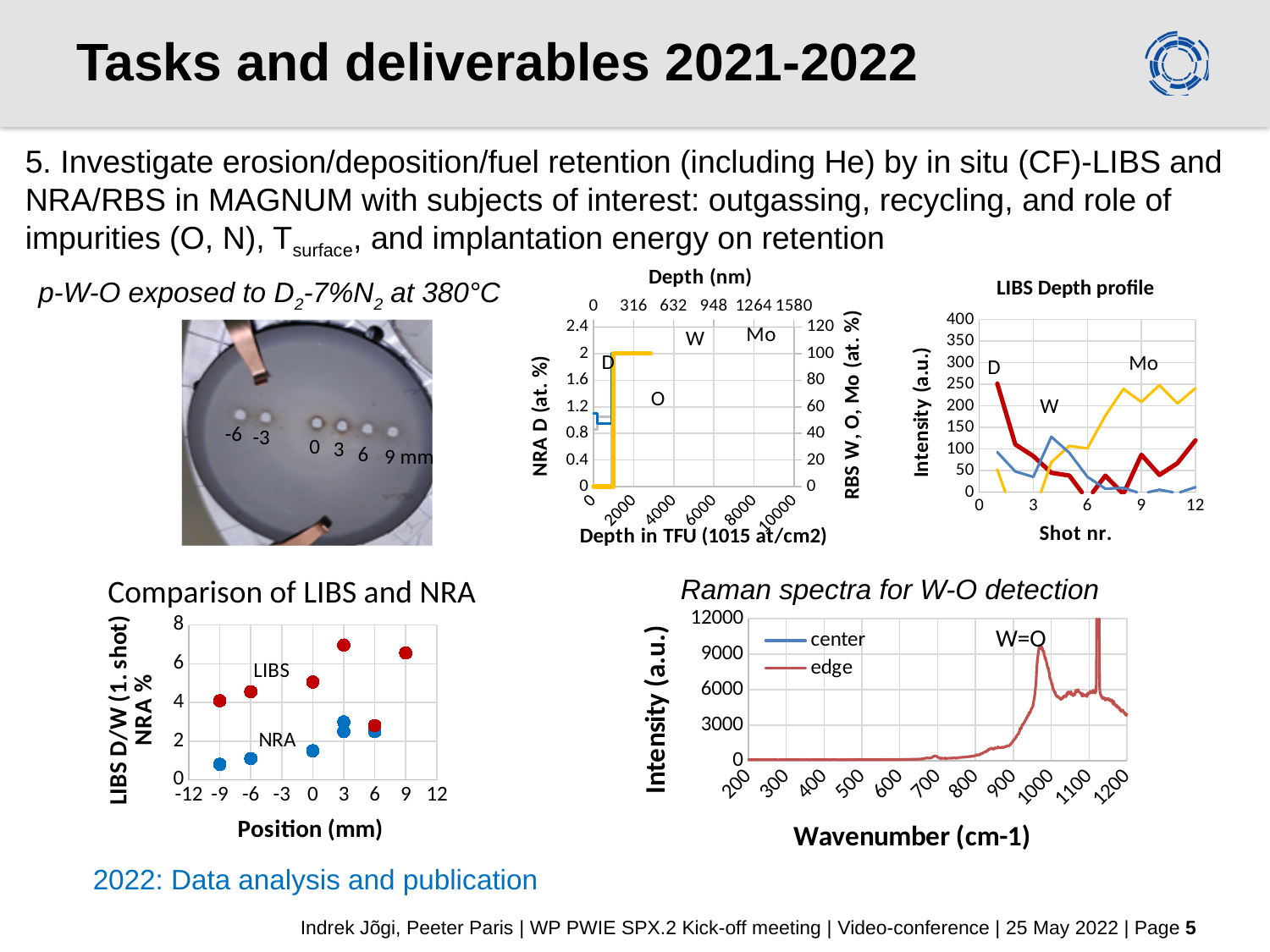
In the LIBS Depth profile chart, is the D intensity at shot 1 greater or less than 200? greater In the Raman spectra for W-O detection chart, what is the label of the x axis? Wavenumber (cm-1) What kind of chart is the LIBS Depth profile? line chart In the LIBS Depth profile chart, what is the label of the x axis? Shot nr. In the Comparison of LIBS and NRA chart, is the LIBS value at position 3 mm greater or less than 6? greater In the LIBS Depth profile chart, does the Mo intensity rise or fall as the shot number increases? rise In the LIBS Depth profile chart, how many series are plotted (D, W, Mo)? 3 In the Raman spectra for W-O detection chart, how many series does the legend list? 2 In the Raman spectra for W-O detection chart, is the edge intensity at the W=O peak near 1000 cm-1 greater or less than 6000? greater In the LIBS Depth profile chart, does the D intensity rise or fall as the shot number increases? fall In the Comparison of LIBS and NRA chart, at position -9 mm, which series has the larger value, LIBS or NRA? LIBS